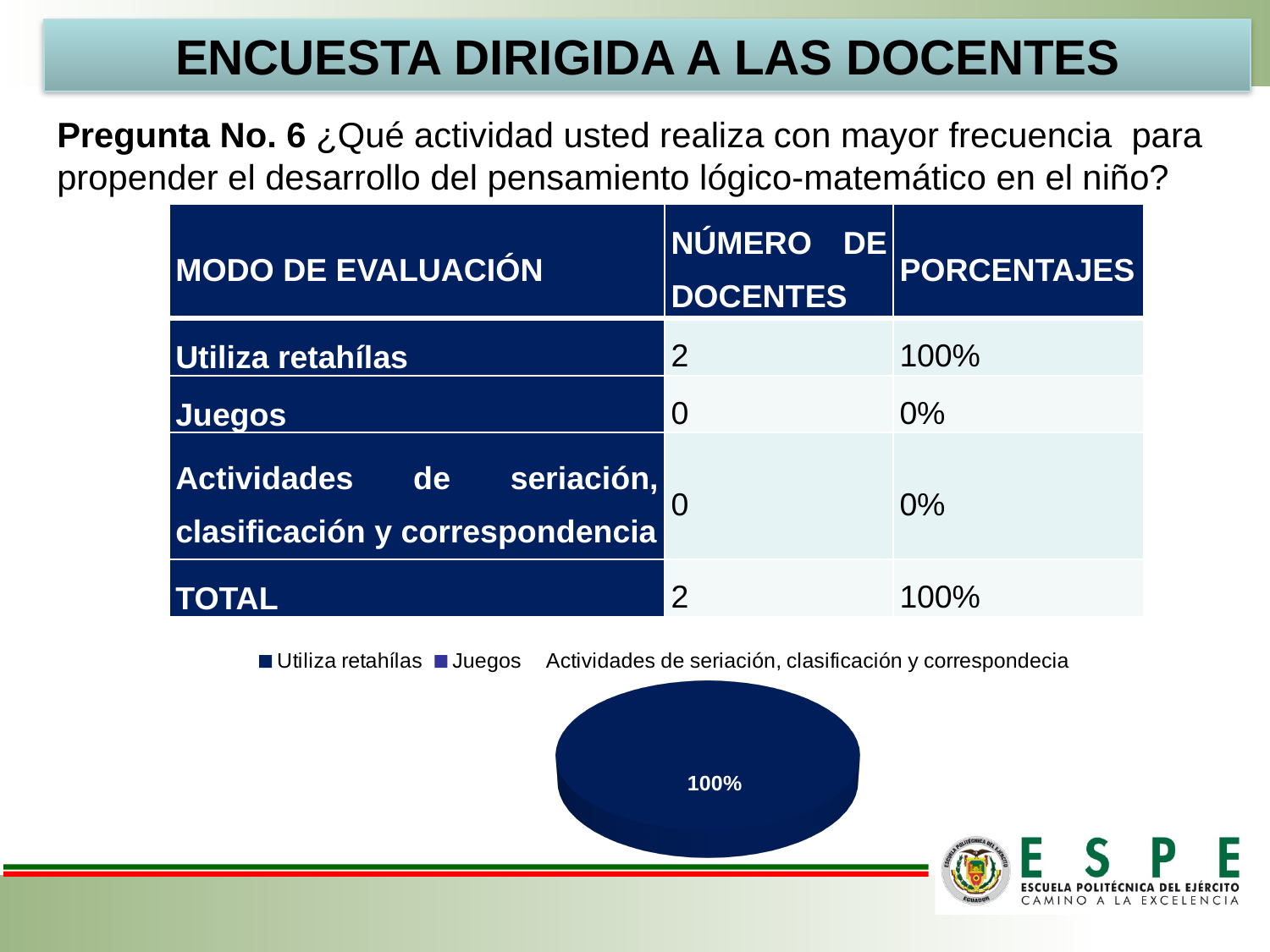
How many categories does the legend of the pie chart list? 3 What kind of chart is shown on the slide? pie chart Is the share for 'Utiliza retahílas' greater or less than 50%? greater How many slices are visible in the pie chart? 1 Which category is listed second in the pie chart's legend? Juegos Which is larger in the pie chart, the share for 'Utiliza retahílas' or the share for 'Juegos'? Utiliza retahílas Which category has the largest share of the pie chart? Utiliza retahílas What is the only data label printed on the pie chart? 100% Which category is listed first in the pie chart's legend? Utiliza retahílas What share of the pie does the 'Utiliza retahílas' slice represent? 100%